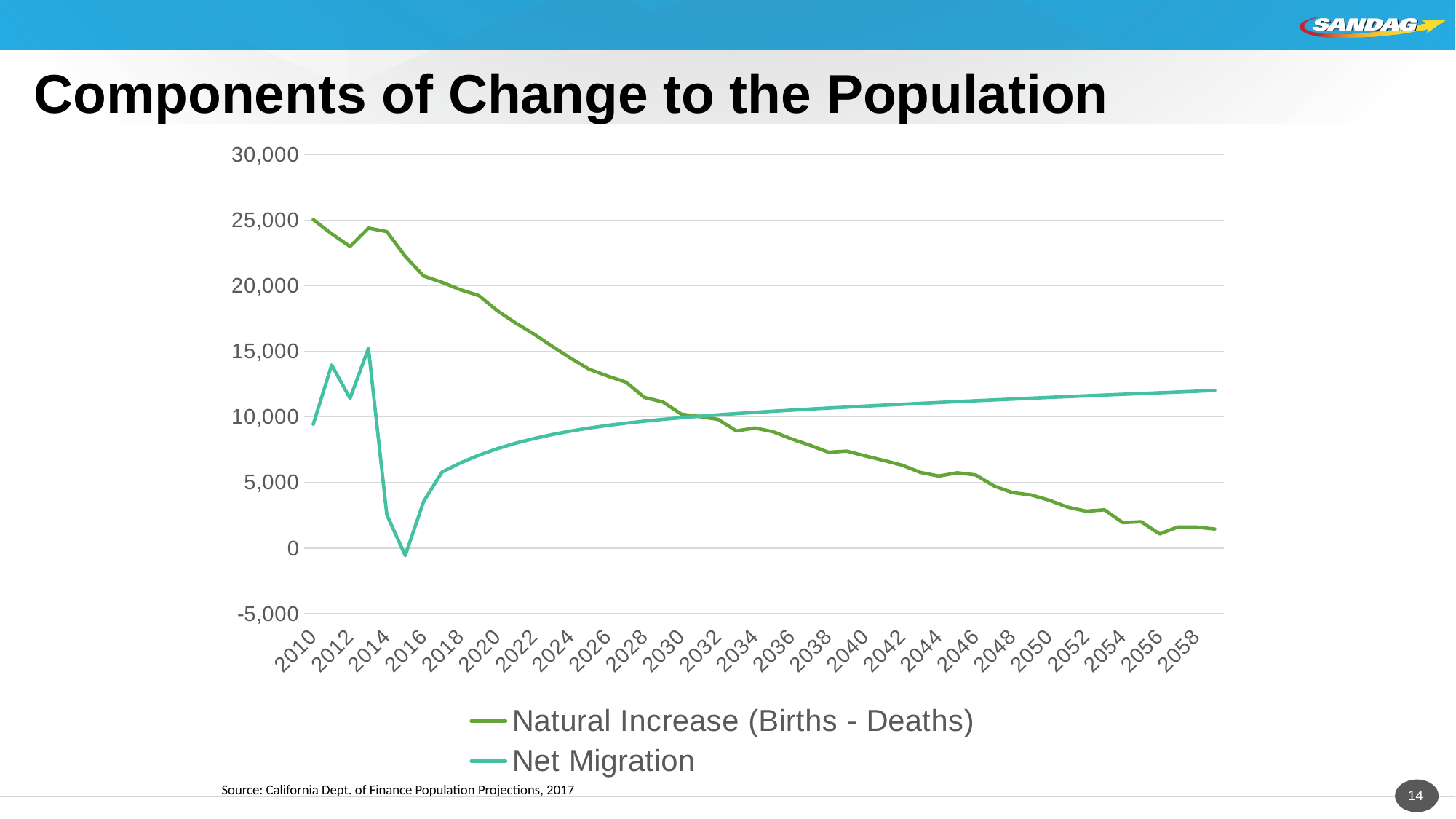
Which series is drawn in the darker green line? Natural Increase (Births - Deaths) How many series does the legend list? 2 Is the value for Natural Increase (Births - Deaths) in 2058 greater or less than 5,000? less Does the Net Migration series rise or fall from 2016 to 2058? rise Is the value for Net Migration in 2058 greater or less than 10,000? greater In 2050, which series has the larger value, Natural Increase (Births - Deaths) or Net Migration? Net Migration Is the value for Natural Increase (Births - Deaths) in 2010 greater or less than 20,000? greater In 2020, which series has the larger value, Natural Increase (Births - Deaths) or Net Migration? Natural Increase (Births - Deaths) What kind of chart is shown on the slide? line chart Does the Natural Increase (Births - Deaths) series rise or fall from 2010 to 2058? fall What is the title of the chart on the slide? Components of Change to the Population